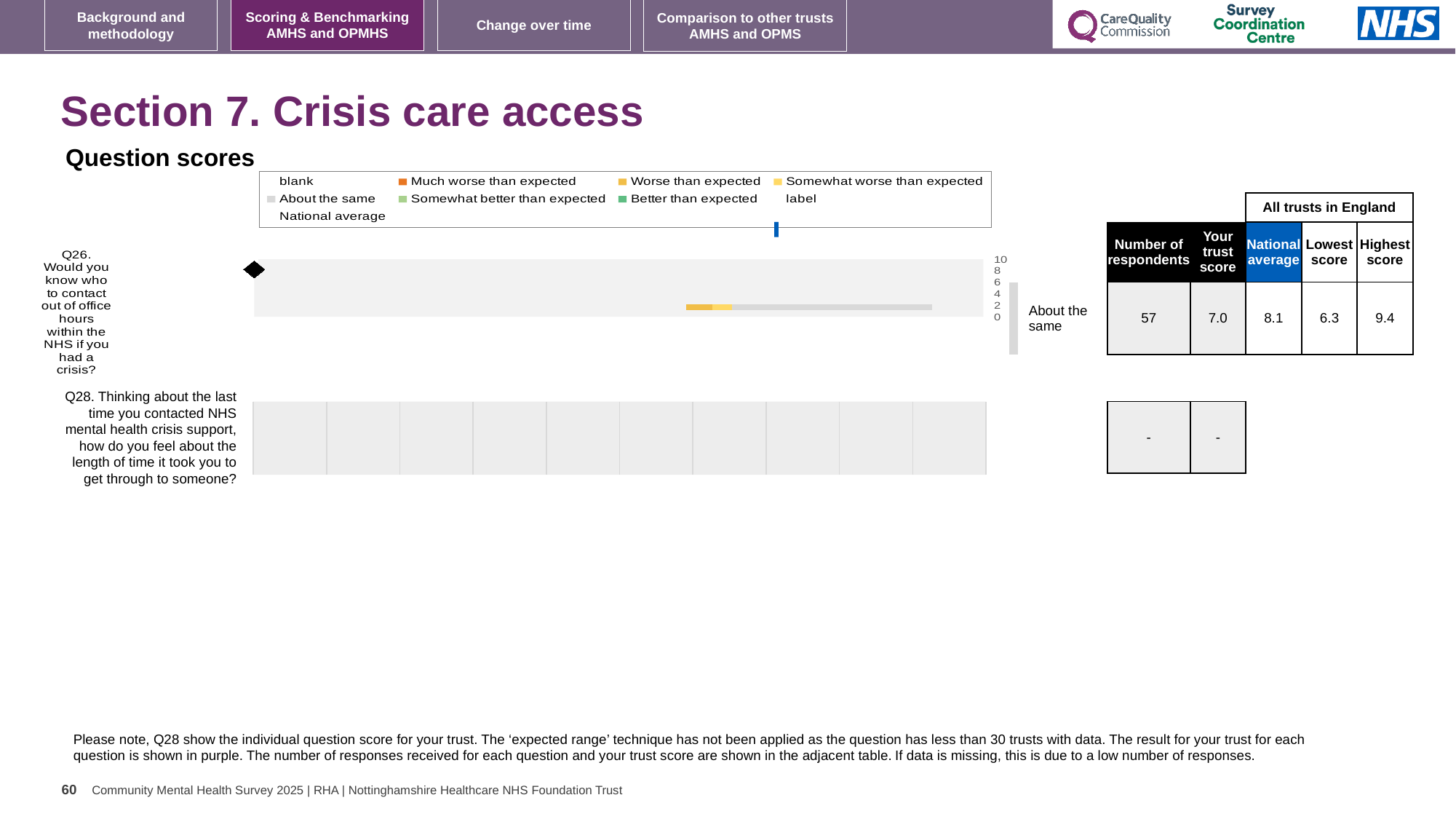
What kind of chart is used to show the question scores? Bar chart By how much does the national average exceed the trust score for Q26? 1.1 What benchmark category is shown for Q26 on the chart? About the same What is the highest score among all trusts in England for Q26? 9.4 What is the difference between the highest score and the lowest score for Q26? 3.1 How many respondents answered Q26? 57 What is the lowest score among all trusts in England for Q26? 6.3 What is the national average for Q26 shown in the table? 8.1 For Q26, which is larger: the trust score or the national average? National average How many questions are plotted on the chart? 2 What is the trust score for Q26 shown in the table next to the chart? 7.0 What is the heading above the chart? Question scores